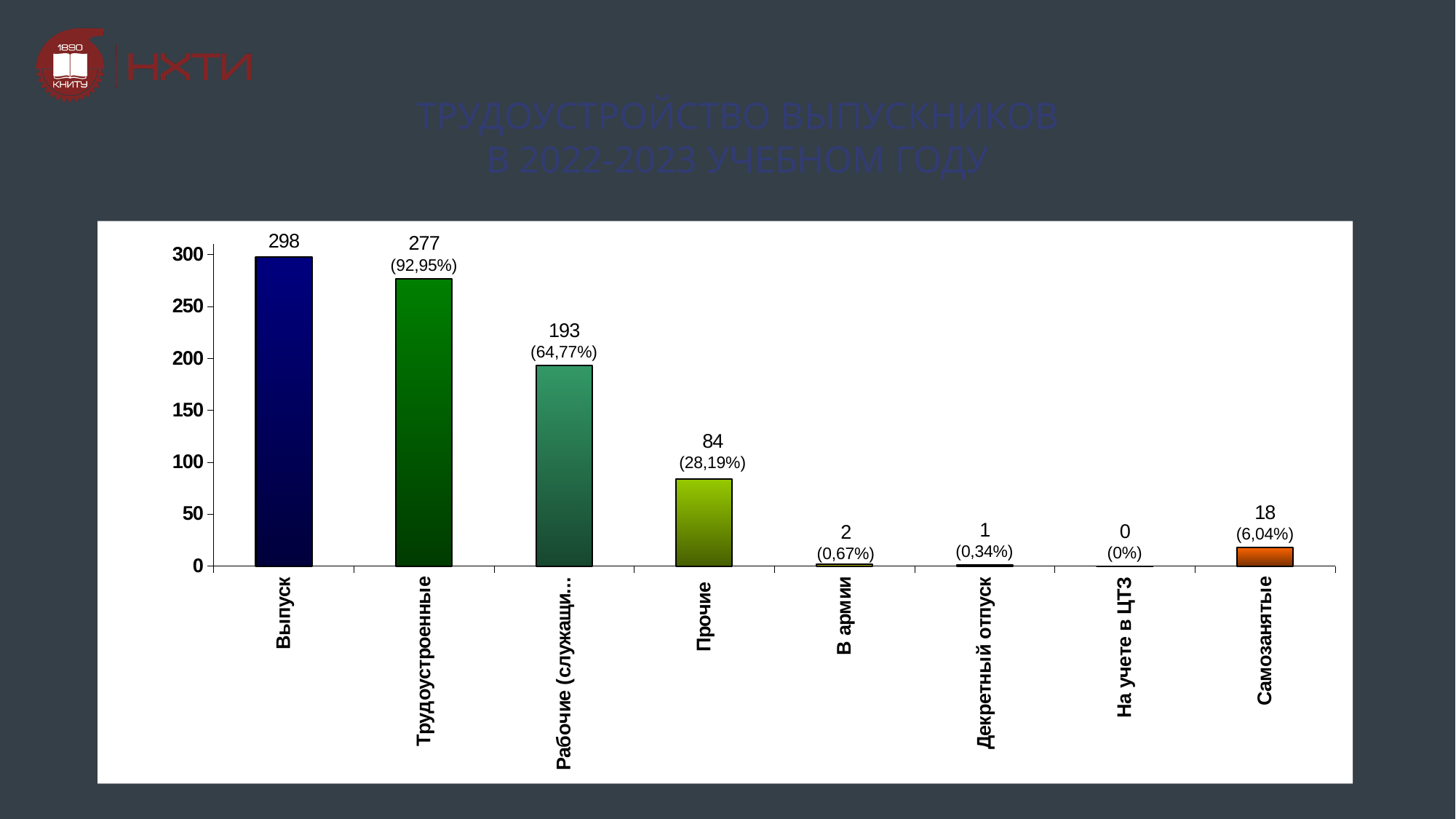
How many categories are shown on the x axis? 8 What is the difference between the values for Выпуск and Трудоустроенные? 21 What percentage is shown for Прочие? 28,19% Which category has the highest value? Выпуск What is the value for Трудоустроенные? 277 What is the value for На учете в ЦТЗ? 0 What percentage is shown for Трудоустроенные? 92,95% What is the value for Самозанятые? 18 Which is larger, the value for В армии or the value for Декретный отпуск? В армии What kind of chart is shown on the slide? bar chart What is the value for Выпуск? 298 Which category has the lowest value? На учете в ЦТЗ